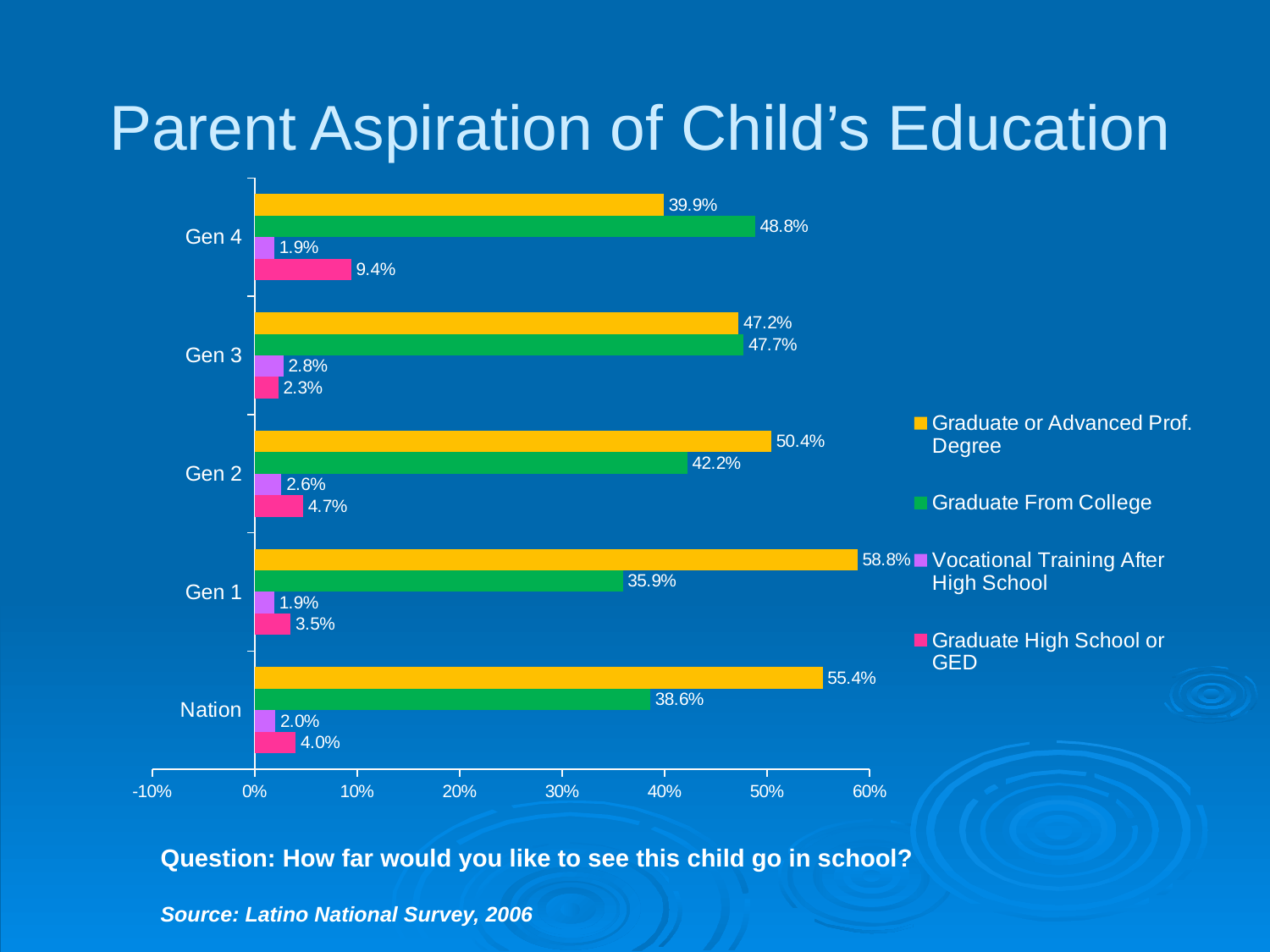
Is the Gen 2 value for Graduate or Advanced Prof. Degree greater or less than 40%? greater For Gen 3, which is larger: Graduate or Advanced Prof. Degree or Graduate From College? Graduate From College What kind of chart is shown on the slide? Bar chart What is the value for Graduate From College in the Gen 4 category? 48.8% Which category has the lowest value for Graduate From College? Gen 1 What percentage of Gen 1 parents aspire for their child to earn a Graduate or Advanced Prof. Degree? 58.8% Which category has the highest value for Graduate or Advanced Prof. Degree? Gen 1 What is the Nation value for Graduate High School or GED? 4.0% What is the title of the chart? Parent Aspiration of Child's Education How many series does the legend list? 4 What is the difference between the Graduate or Advanced Prof. Degree values for Nation and Gen 4? 15.5% How many categories are shown on the vertical axis? 5